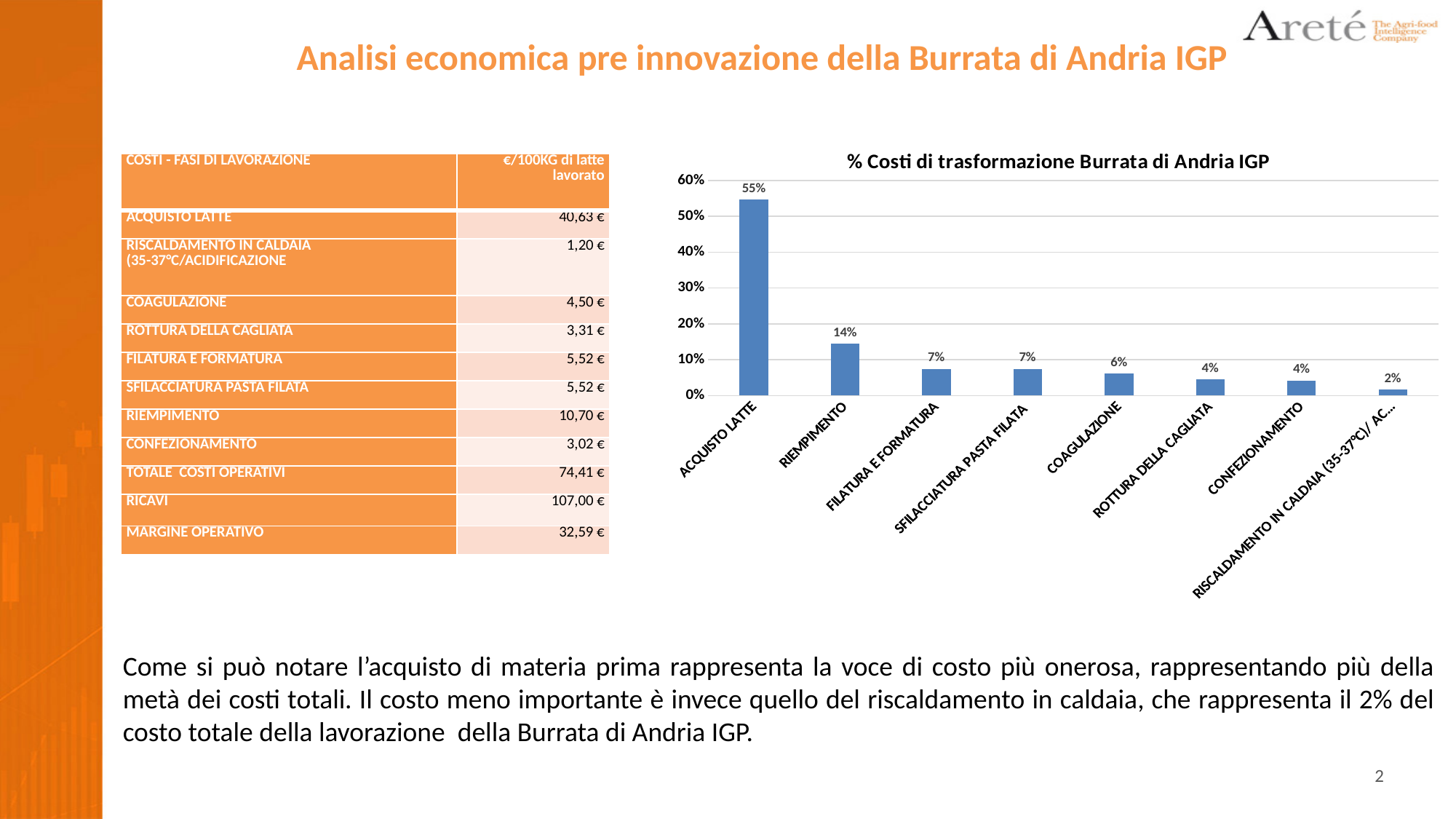
How many categories are shown in the chart? 8 What kind of chart is shown on the slide? bar chart Is the value for ACQUISTO LATTE greater or less than 50%? greater Which category has the lowest value in the chart? RISCALDAMENTO IN CALDAIA What is the value for ACQUISTO LATTE in the chart? 55% What is the title of the chart? % Costi di trasformazione Burrata di Andria IGP What is the value for CONFEZIONAMENTO in the chart? 4% Which category has the highest value in the chart? ACQUISTO LATTE What is the value for COAGULAZIONE in the chart? 6% What is the value for RIEMPIMENTO in the chart? 14% Which is larger, the value for COAGULAZIONE or the value for ROTTURA DELLA CAGLIATA? COAGULAZIONE What is the difference between the values for ACQUISTO LATTE and RIEMPIMENTO? 41%